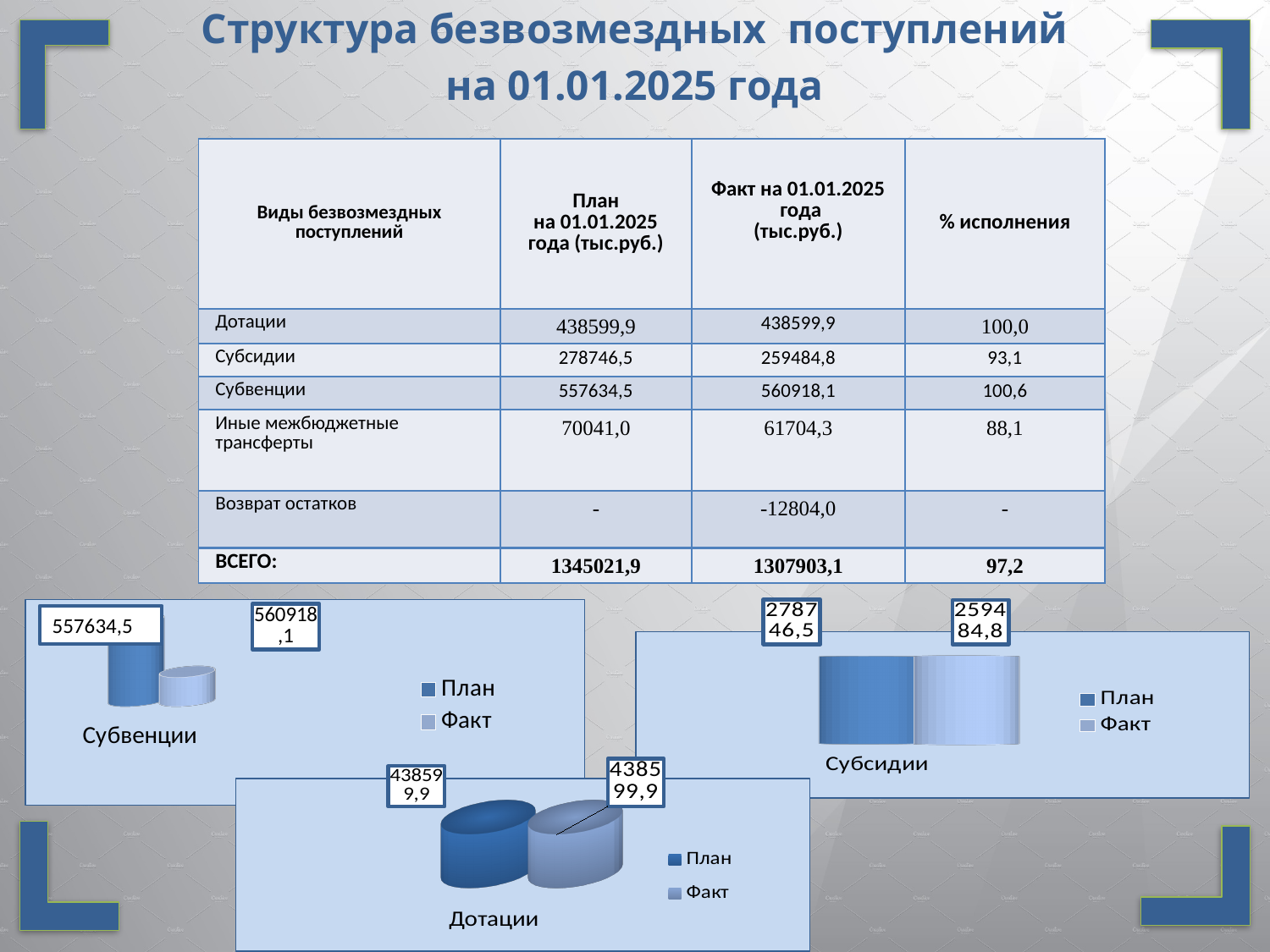
In the Субвенции chart, what is the value for Факт? 560918,1 What kind of chart is the Субсидии chart? Bar chart What are the two legend entries in the Субвенции chart? План and Факт How many series does the legend of the Дотации chart list? 2 In the Субсидии chart, what is the value for План? 278746,5 In the Субсидии chart, what is the difference between План and Факт? 19261,7 In the Дотации chart, what is the value for План? 438599,9 In the Дотации chart, what is the value for Факт? 438599,9 In the Субвенции chart, what is the difference between Факт and План? 3283,6 In the Субвенции chart, what is the value for План? 557634,5 In the Субсидии chart, what is the value for Факт? 259484,8 In the Субсидии chart, which is larger, План or Факт? План